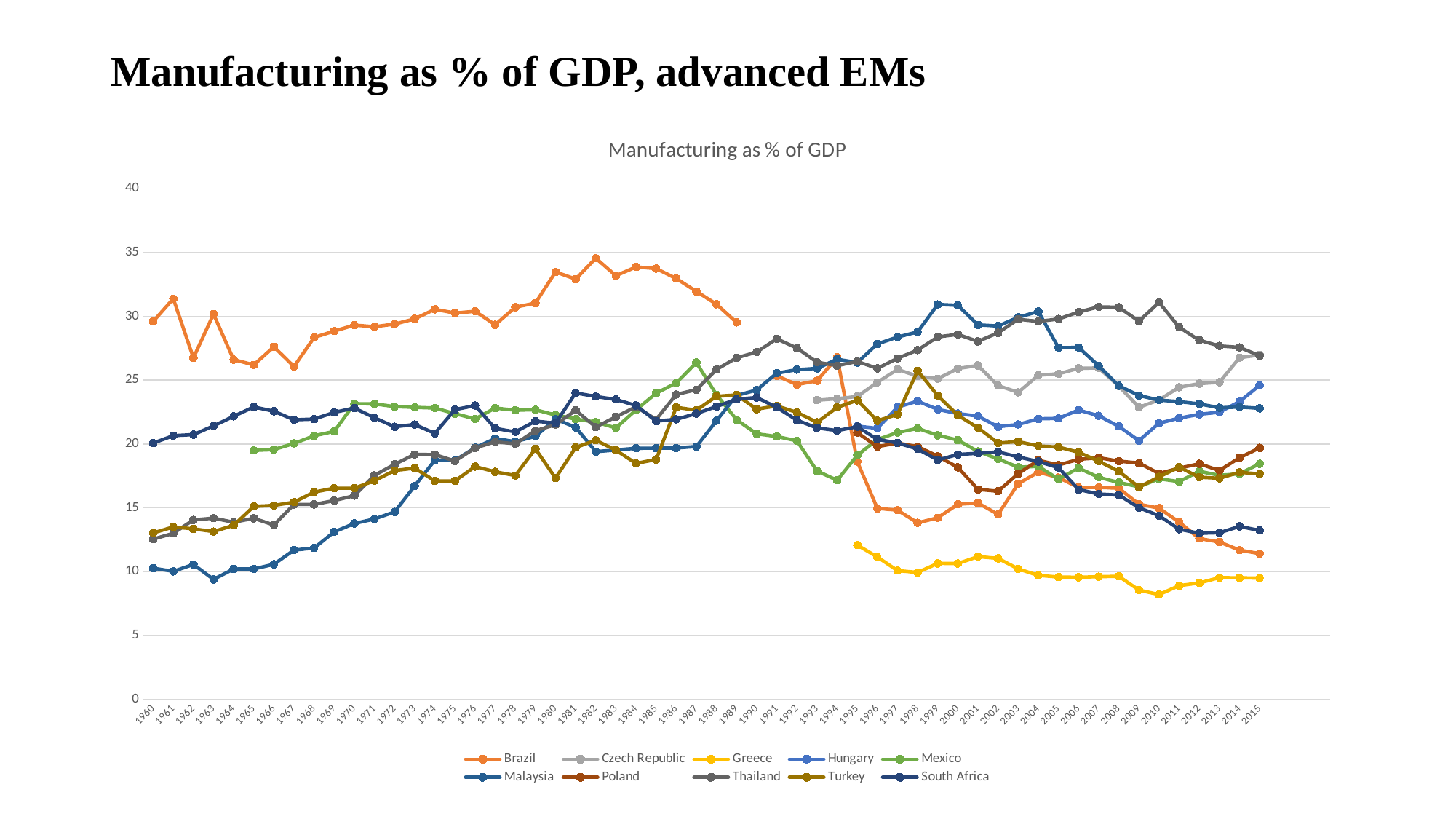
Is the value for Brazil in 1982 greater or less than 30? greater How many years are shown on the x axis? 56 Is the value for Hungary in 2015 greater or less than 20? greater Which series has the lowest value in 2015? Greece Does the value for Greece rise or fall overall from 1995 to 2015? fall In 2015, which is larger, the value for Thailand or the value for Greece? Thailand What is the title printed above the chart area? Manufacturing as % of GDP Which series has the highest value in 1960? Brazil What kind of chart is shown on the slide? Line chart Is the value for Greece in 2010 greater or less than 10? less How many series does the legend list? 10